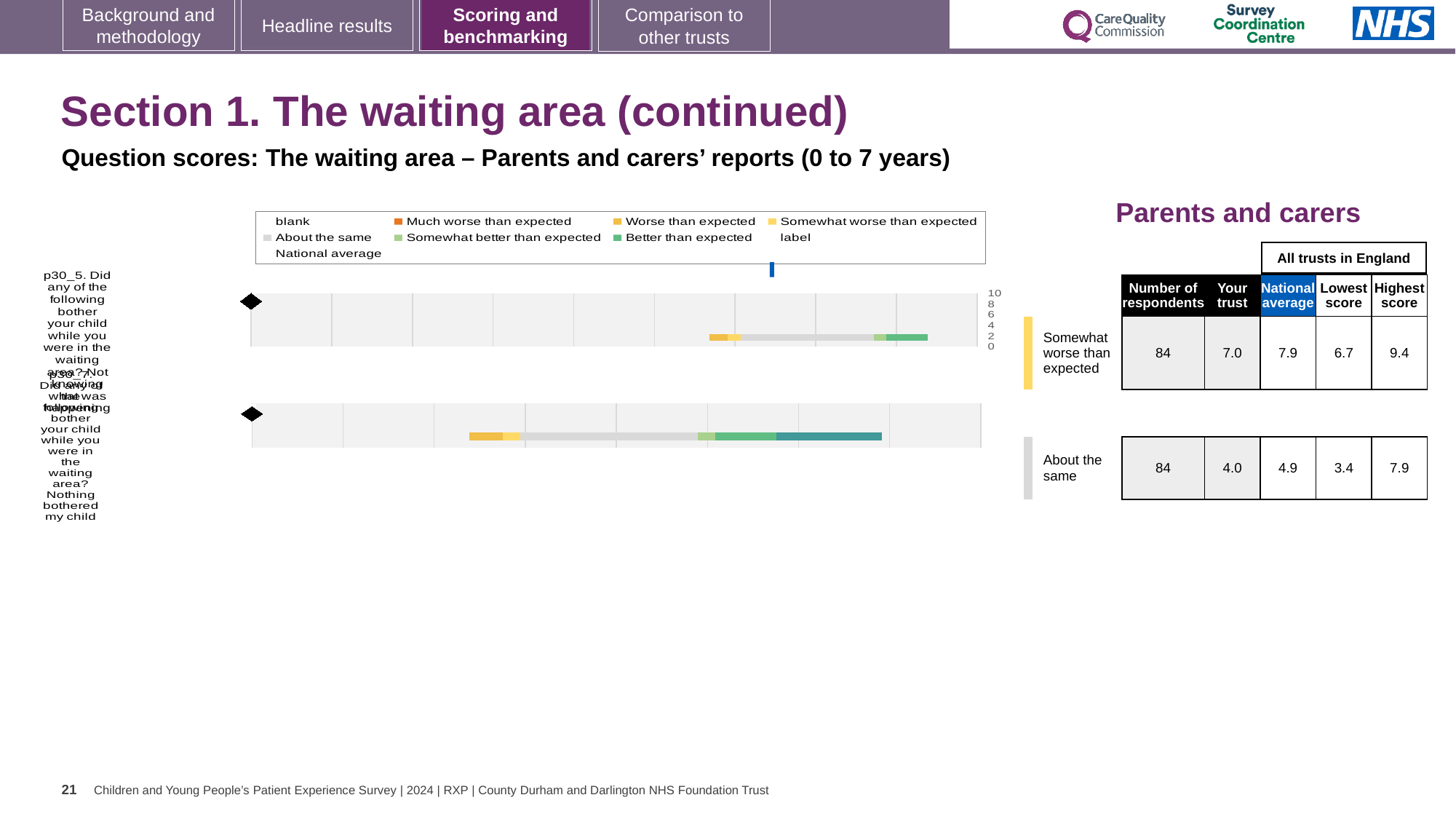
What colour represents 'About the same' in the chart legend? grey Which of the two questions has the higher 'Your trust' score? Somewhat worse than expected In the table beside the chart, what is the 'Your trust' score for the question rated 'Somewhat worse than expected'? 7.0 How many entries does the chart legend list? 9 For the question rated 'Somewhat worse than expected', what is the difference between the highest score and the lowest score? 2.7 In the table beside the chart, how many respondents answered the question rated 'Somewhat worse than expected'? 84 In the table beside the chart, what is the lowest score for the question rated 'About the same'? 3.4 What kind of chart is shown on the slide? bar chart What colour represents 'Much worse than expected' in the chart legend? orange How many question bars are plotted in the chart? 2 For the question rated 'Somewhat worse than expected', which is larger: the 'Your trust' score or the national average? National average In the table beside the chart, what is the national average for the question rated 'About the same'? 4.9